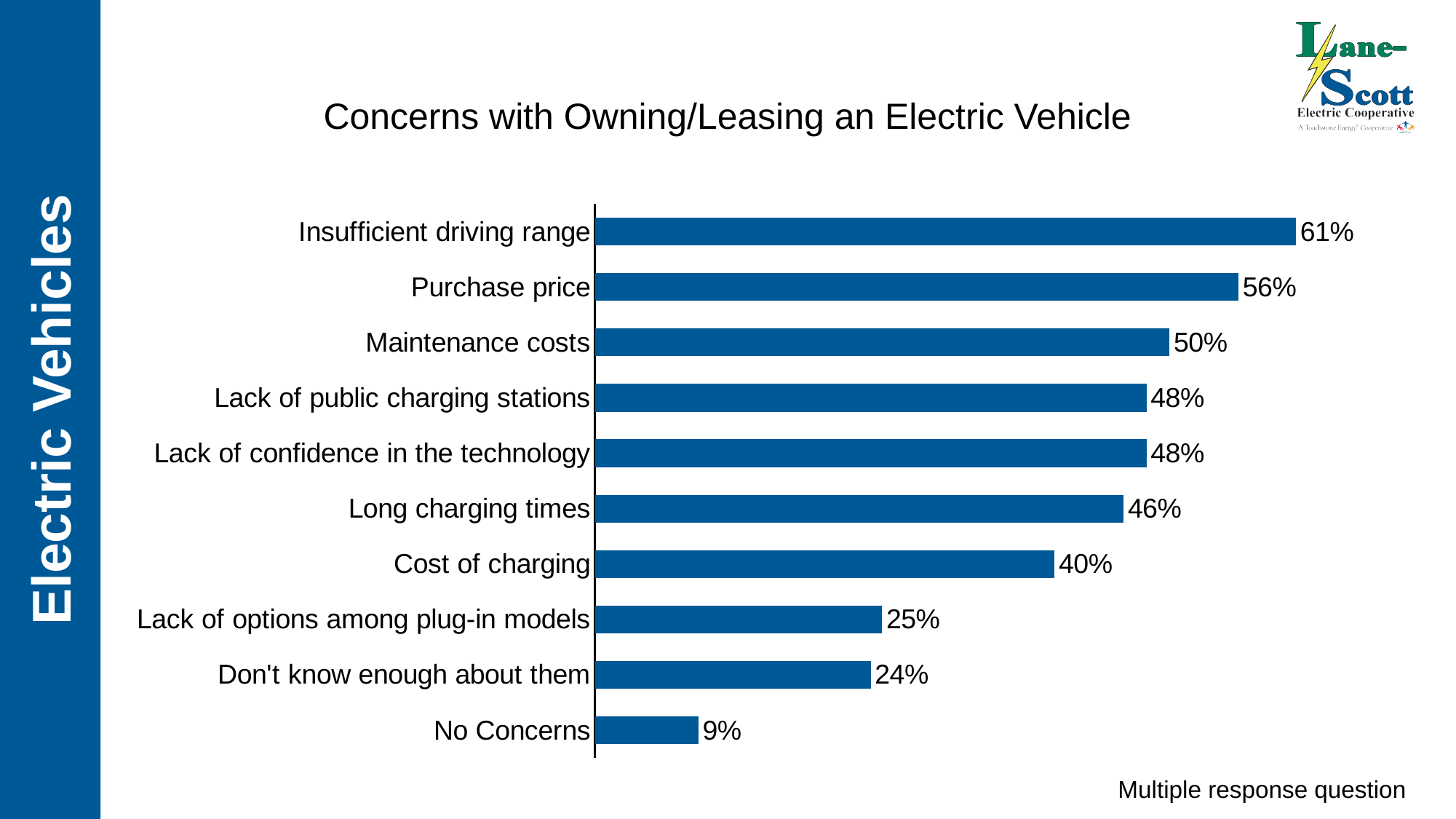
Which concern has the highest value? Insufficient driving range What kind of chart is shown on the slide? Bar chart What is the value for Don't know enough about them? 24% What is the difference between Insufficient driving range and No Concerns? 52% What is the difference between Purchase price and Maintenance costs? 6% Which is larger, Long charging times or Cost of charging? Long charging times Which category has the lowest value? No Concerns Which is larger, Lack of options among plug-in models or Don't know enough about them? Lack of options among plug-in models How many categories are shown in the chart? 10 What percentage of respondents cited insufficient driving range as a concern? 61% What is the value for Cost of charging? 40% What is the title of the chart? Concerns with Owning/Leasing an Electric Vehicle